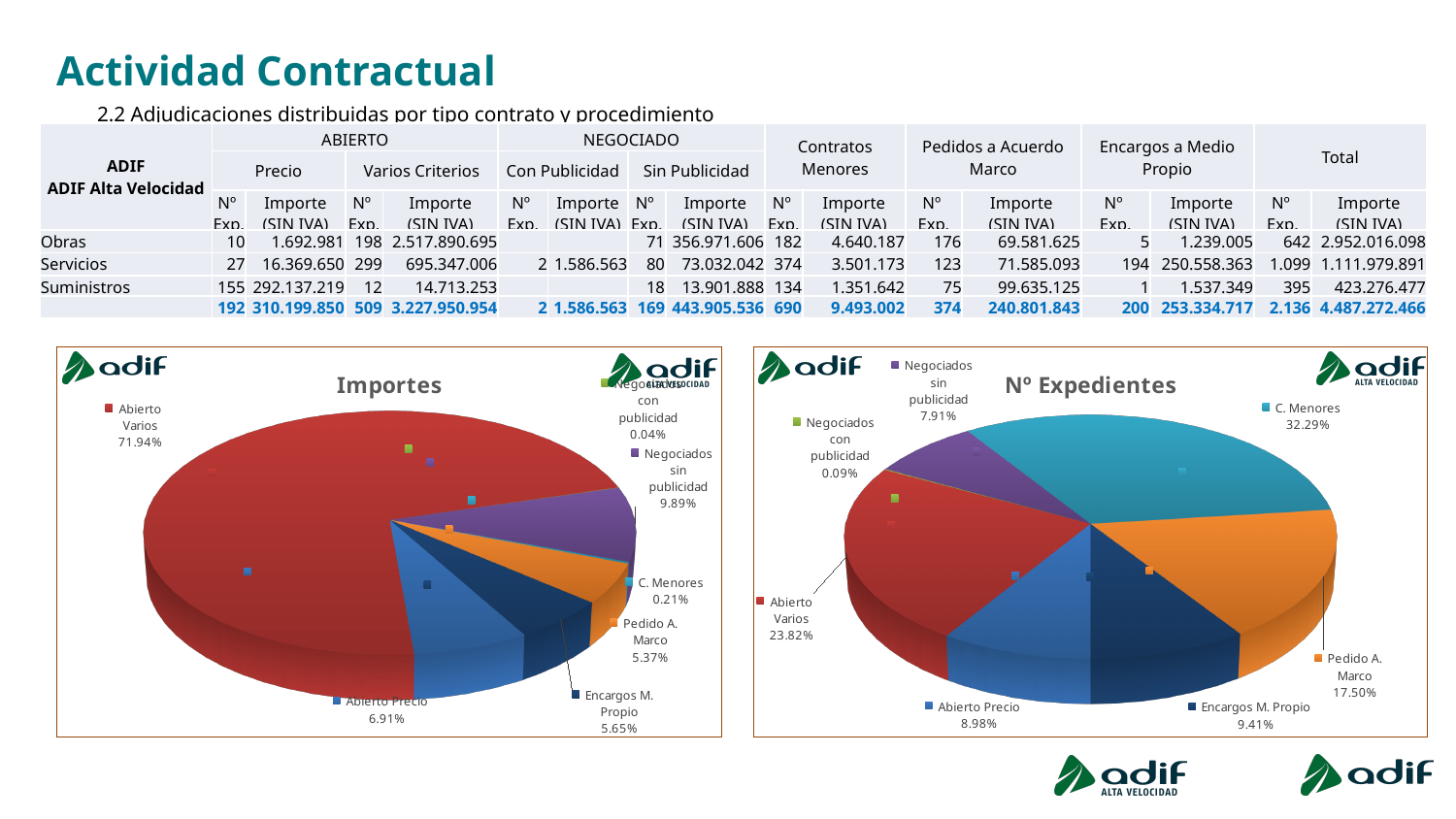
In the 'Nº Expedientes' pie chart, which is larger, Abierto Varios or Pedido A. Marco? Abierto Varios In the 'Nº Expedientes' pie chart, what share does C. Menores have? 32.29% In the 'Nº Expedientes' pie chart, what share does Pedido A. Marco have? 17.50% In the 'Nº Expedientes' pie chart, what is the difference between the shares of Encargos M. Propio and Abierto Precio? 0.43% What type of chart is the 'Importes' chart? Pie chart How many slices does the 'Nº Expedientes' pie chart have? 7 In the 'Nº Expedientes' pie chart, which category has the largest share? C. Menores In the 'Importes' pie chart, what is the difference between the shares of Abierto Precio and Encargos M. Propio? 1.26% In the 'Importes' pie chart, what share does Negociados sin publicidad have? 9.89% In the 'Importes' pie chart, which category has the smallest share? Negociados con publicidad In the 'Importes' pie chart, which category has the largest share? Abierto Varios In the 'Importes' pie chart, what share does Abierto Varios have? 71.94%